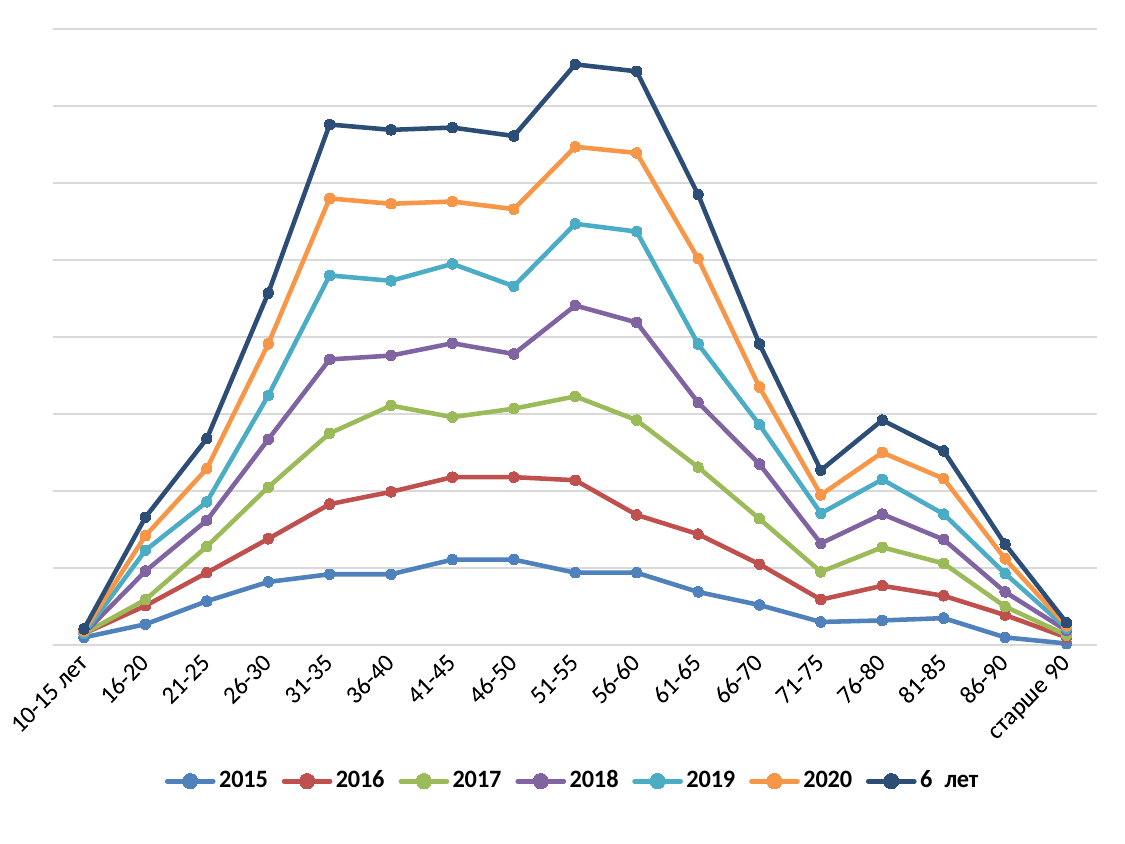
How many age categories are shown on the x axis? 17 Do the values of the 2020 series rise or fall from 10-15 лет to 31-35? rise How many series does the legend list? 7 In which age category does the "6 лет" series reach its highest value? 51-55 Do the values of the "6 лет" series rise or fall from 56-60 to 71-75? fall What kind of chart is shown on the slide? line chart